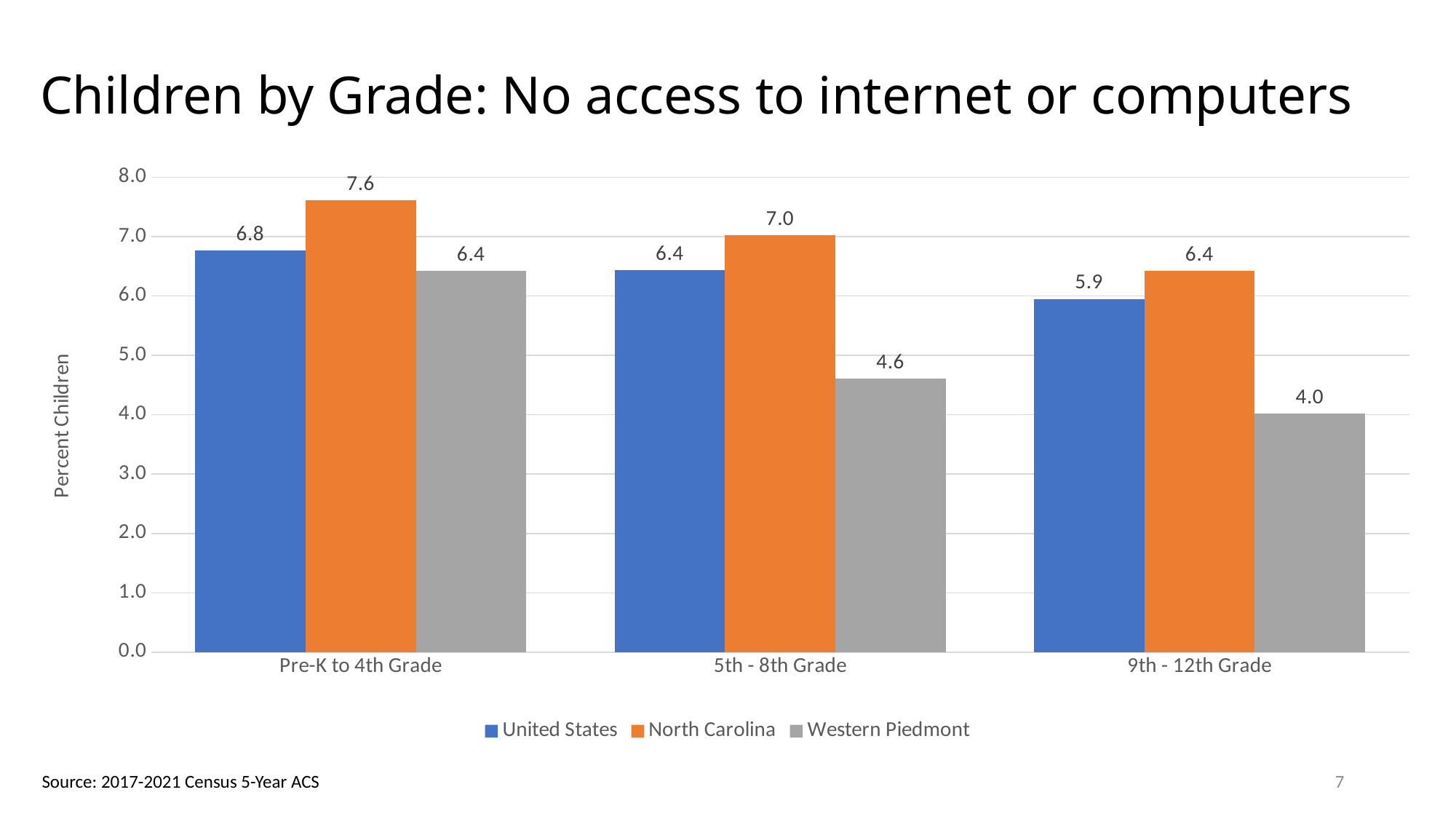
What kind of chart is shown on the slide? bar chart What is the value for Western Piedmont in the 9th - 12th Grade category? 4.0 How many grade categories are shown on the x axis? 3 Which grade category has the highest value for Western Piedmont? Pre-K to 4th Grade Is the value for Western Piedmont in the 5th - 8th Grade category greater or less than 5.0? less Which is larger in the 9th - 12th Grade category: the United States value or the Western Piedmont value? United States What is the value for the United States in the 5th - 8th Grade category? 6.4 Do the Western Piedmont values rise or fall from Pre-K to 4th Grade to 9th - 12th Grade? fall What is the difference between the North Carolina and Western Piedmont values in the 5th - 8th Grade category? 2.4 Which grade category has the lowest value for North Carolina? 9th - 12th Grade How many series does the legend list? 3 What is the value for North Carolina in the Pre-K to 4th Grade category? 7.6